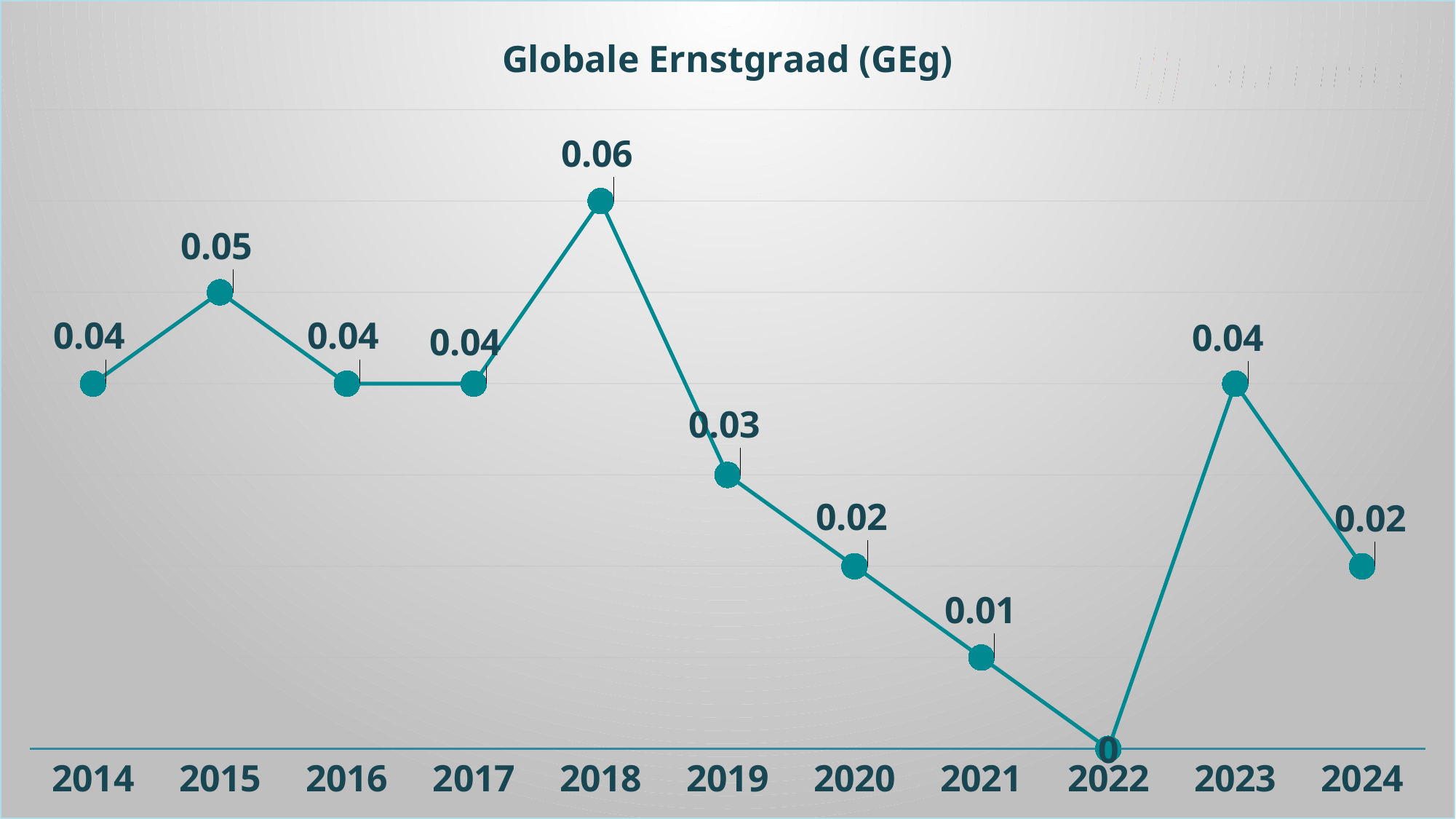
What is the title of the chart? Globale Ernstgraad (GEg) What is the difference between the values for 2018 and 2019? 0.03 Do the values rise or fall from 2018 to 2022? fall Which year has the highest value? 2018 What is the value for 2022? 0 Which year has the lowest value? 2022 What is the value for 2015? 0.05 What is the value for 2024? 0.02 What kind of chart is shown? line chart Which is larger, the value for 2023 or the value for 2024? 2023 How many years are plotted on the chart? 11 What is the value for 2018? 0.06